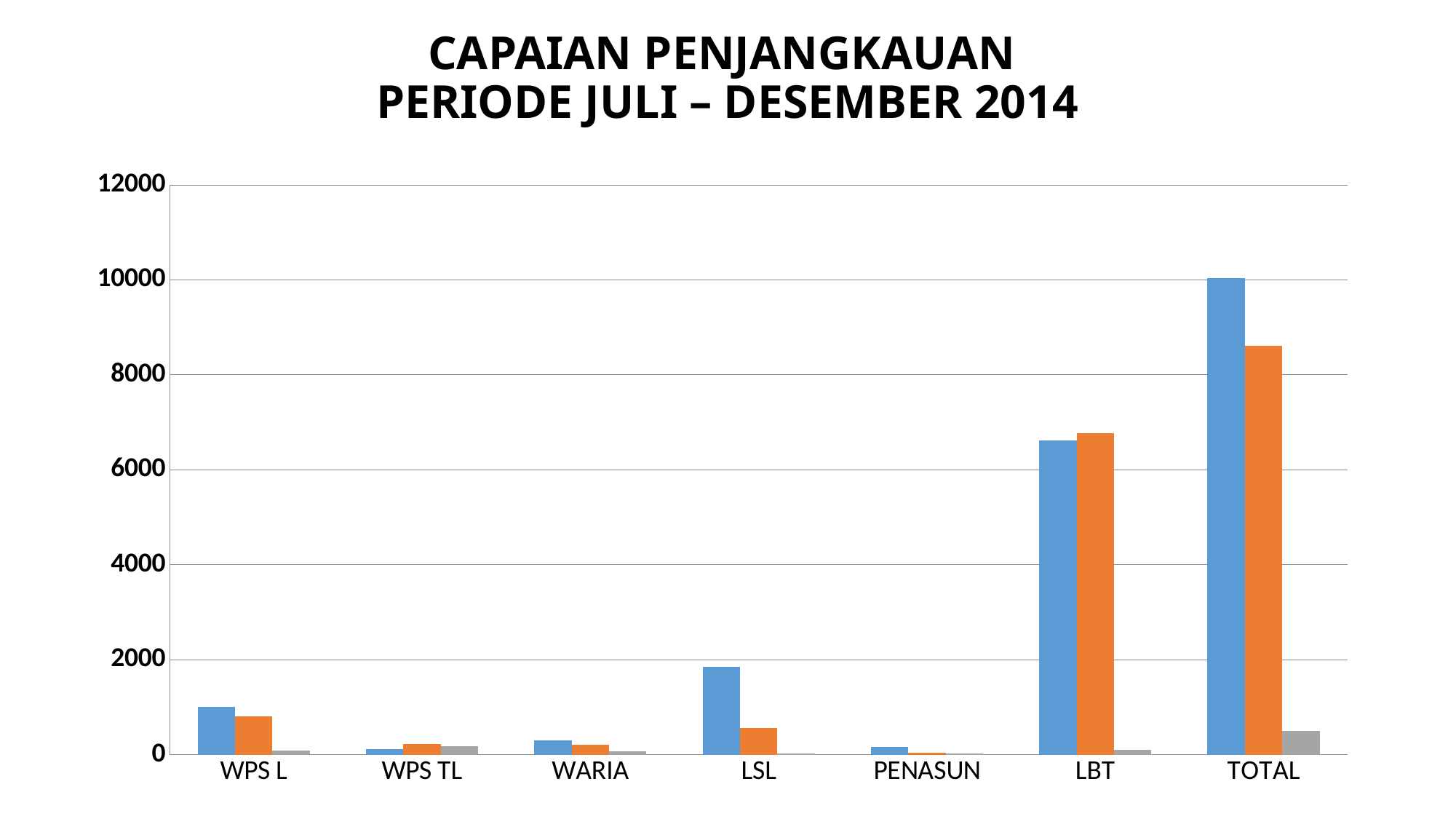
Is the blue bar for LSL greater or less than 2000? less Is the orange bar for TOTAL greater or less than 8000? greater How many bars are plotted for each category? 3 For LSL, which is larger, the blue bar or the orange bar? blue bar Which category has the lowest orange bar? PENASUN Which category has the tallest blue bar? TOTAL Which category has the tallest orange bar? TOTAL What kind of chart is shown on the slide? bar chart Is the blue bar for TOTAL greater or less than 8000? greater What is the title of the chart? CAPAIAN PENJANGKAUAN PERIODE JULI – DESEMBER 2014 How many categories are shown along the x axis? 7